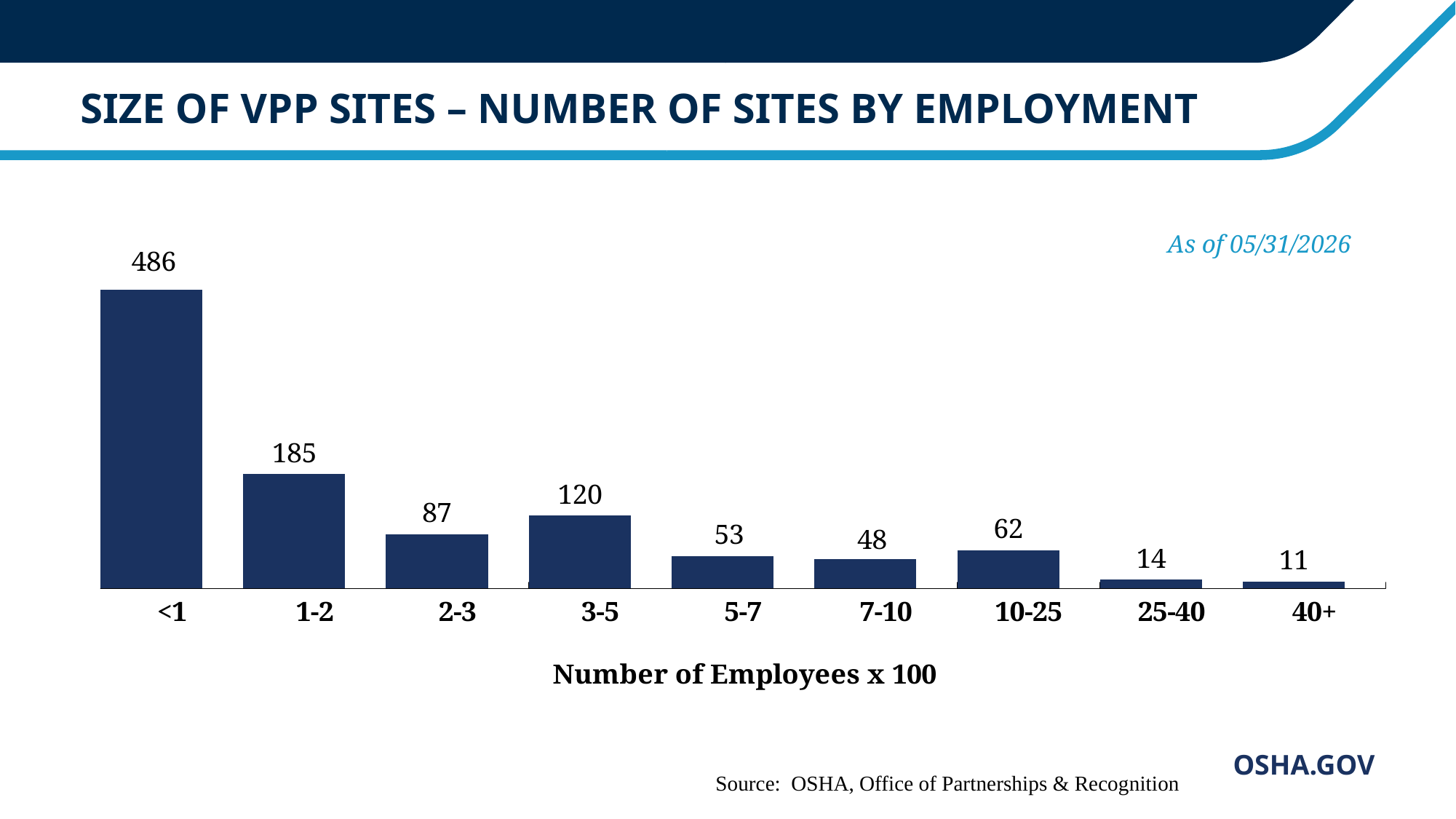
What is the x-axis title of the chart? Number of Employees x 100 Which has more sites, the "5-7" category or the "10-25" category? 10-25 How many employment categories are shown on the x axis? 9 What kind of chart is shown on the slide? Bar chart What is the number of sites in the "3-5" employment category? 120 Which has more sites, the "25-40" category or the "40+" category? 25-40 What is the number of sites in the "10-25" employment category? 62 What is the difference between the number of sites in the "3-5" category and the "2-3" category? 33 Which employment category has the highest number of sites? <1 What is the difference between the number of sites in the "<1" category and the "1-2" category? 301 Which employment category has the lowest number of sites? 40+ How many VPP sites have fewer than 100 employees (the "<1" category)? 486